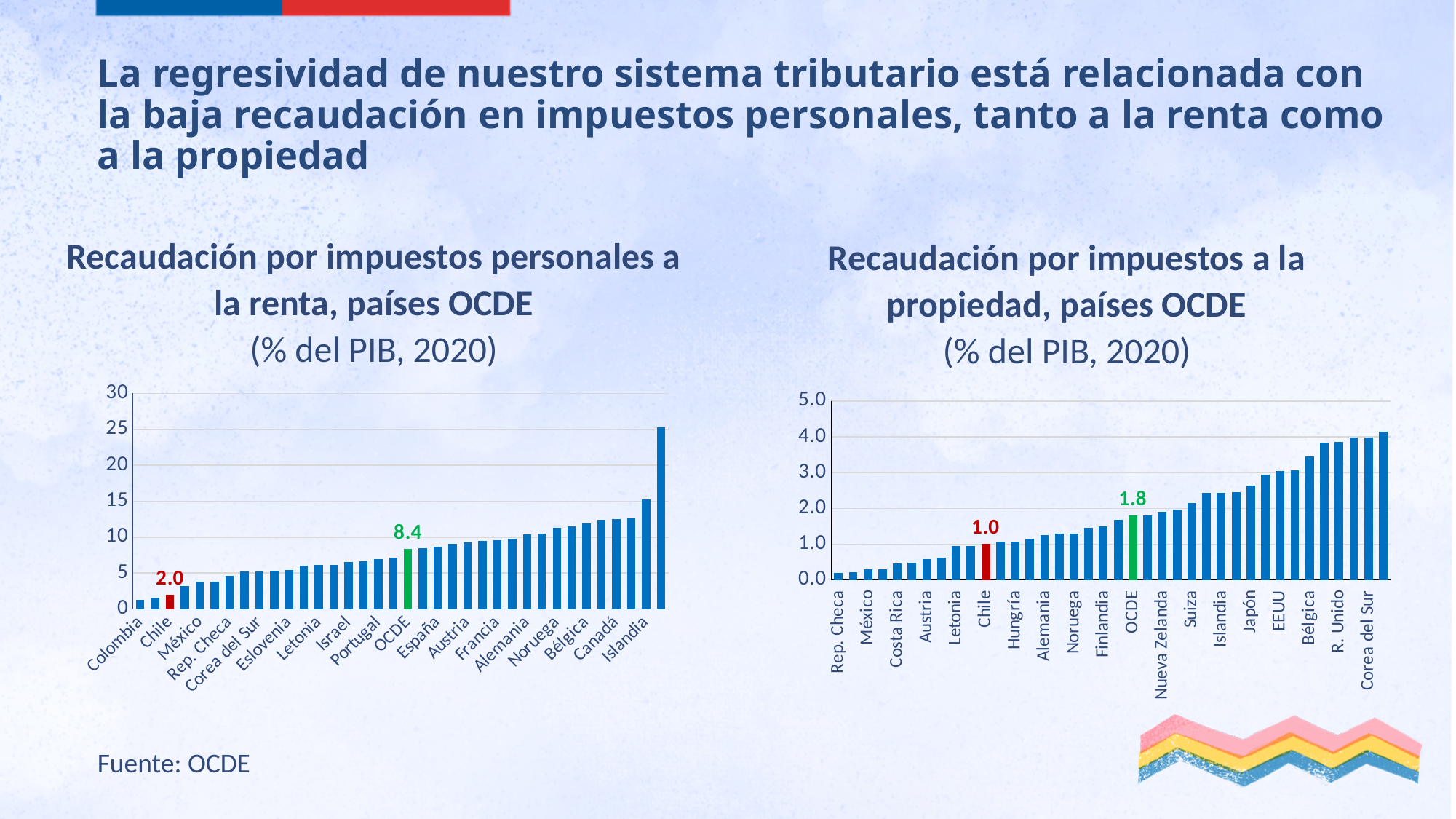
In the right chart (Recaudación por impuestos a la propiedad), what is the value for Chile? 1.0 In the left chart (Recaudación por impuestos personales a la renta), which is larger, the value for Chile or the value for OCDE? OCDE In the right chart (Recaudación por impuestos a la propiedad), is the value for Corea del Sur greater or less than 3.0? greater What kind of chart is the right chart (Recaudación por impuestos a la propiedad)? bar chart In the left chart (Recaudación por impuestos personales a la renta), what colour is the bar for Chile? red In the right chart (Recaudación por impuestos a la propiedad), what is the value for OCDE? 1.8 In the left chart (Recaudación por impuestos personales a la renta), what is the difference between the OCDE value and the Chile value? 6.4 In the left chart (Recaudación por impuestos personales a la renta), what is the value for OCDE? 8.4 In the right chart (Recaudación por impuestos a la propiedad), what is the difference between the OCDE value and the Chile value? 0.8 In the left chart (Recaudación por impuestos personales a la renta), is the value for Colombia greater or less than 5? less In the left chart (Recaudación por impuestos personales a la renta), what is the value for Chile? 2.0 In the right chart (Recaudación por impuestos a la propiedad), is the value for Rep. Checa greater or less than 1.0? less